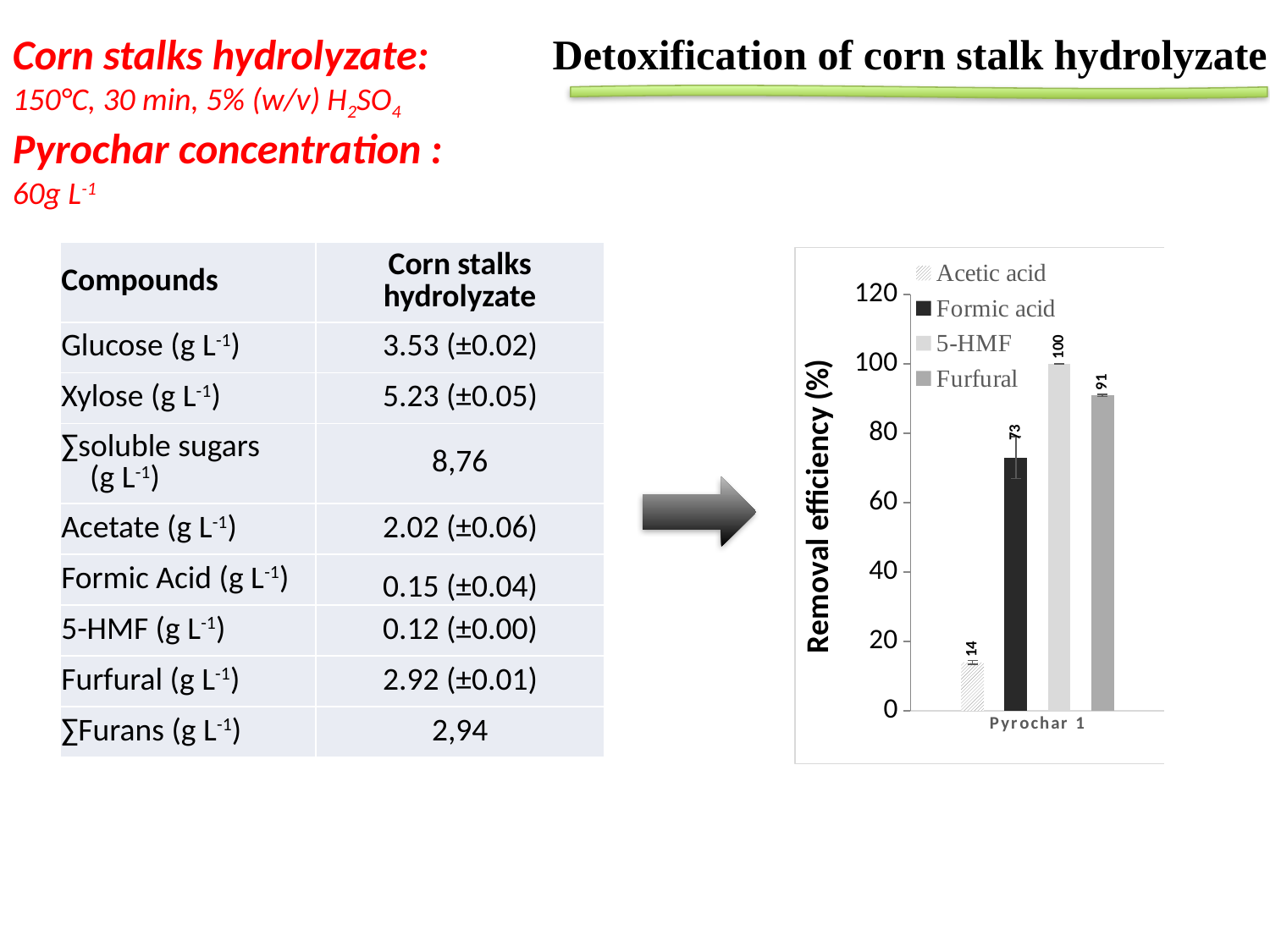
Which compound has the lowest removal efficiency in the chart? Acetic acid What type of chart is shown on the slide? bar chart How many series does the chart legend list? 4 Which compound has the highest removal efficiency in the chart? 5-HMF What is the removal efficiency for Formic acid with Pyrochar 1? 73 What is the removal efficiency for Acetic acid with Pyrochar 1? 14 Which has a higher removal efficiency, Formic acid or Furfural? Furfural What is the removal efficiency for Furfural with Pyrochar 1? 91 Is the removal efficiency for Formic acid greater or less than 80? less What is the difference in removal efficiency between 5-HMF and Furfural? 9 What is the removal efficiency for 5-HMF with Pyrochar 1? 100 What is the difference in removal efficiency between Formic acid and Acetic acid? 59